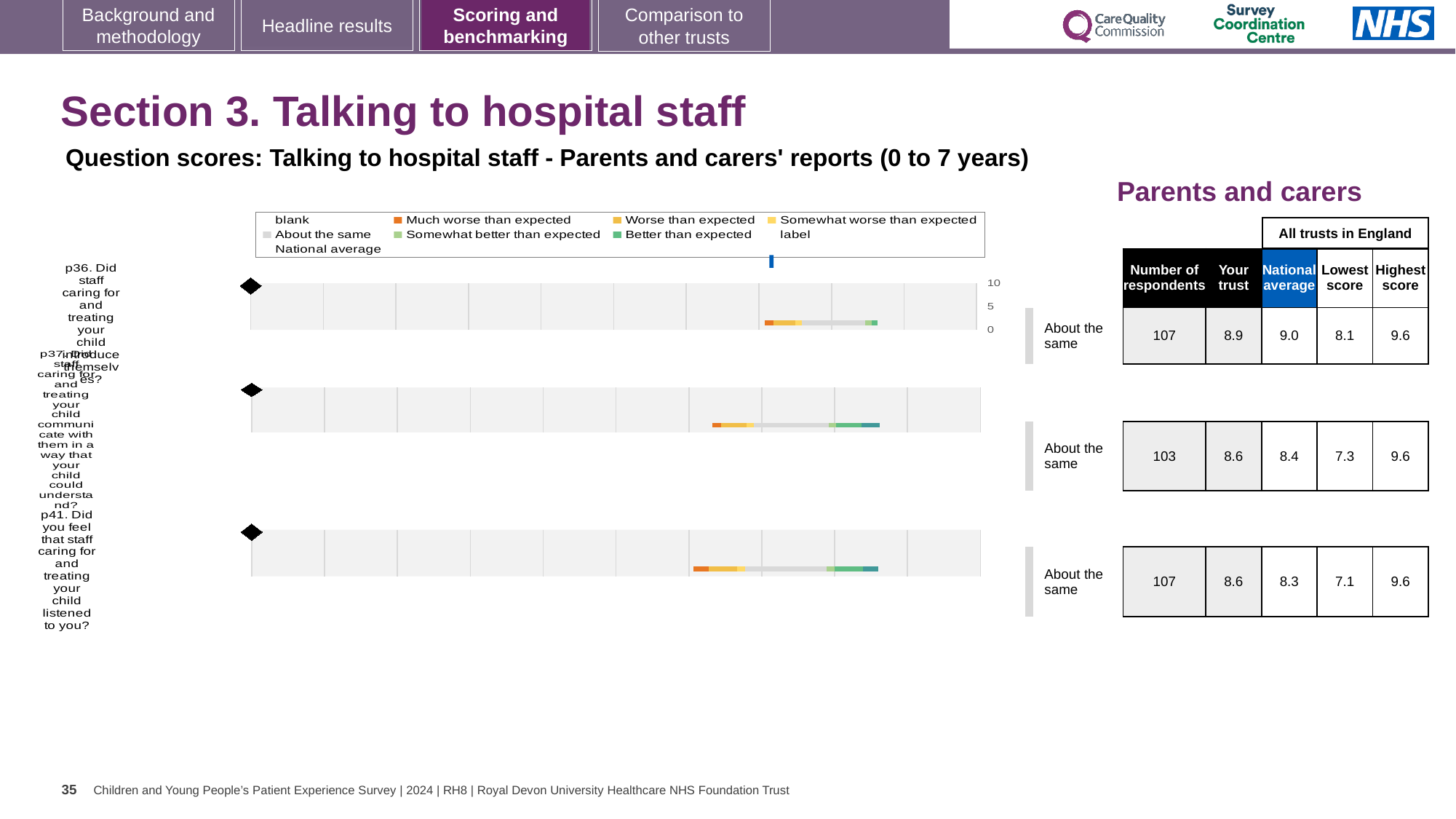
For p37, which is larger: the 'Your trust' score or the national average? Your trust In the table, what is the lowest score across all trusts in England for p36? 8.1 What kind of chart is shown on the slide? bar chart For p41, what is the difference between the highest score and the lowest score in the table? 2.5 In the table, what is the 'Your trust' score for the first question (p36)? 8.9 In the table, what is the national average for the third question (p41)? 8.3 What benchmark label is shown next to each of the three questions? About the same How many survey questions are plotted in the chart? 3 In the table, what is the highest score across all trusts in England for p37? 9.6 What colour does the legend use for 'Much worse than expected'? orange In the table, how many respondents are listed for the second question (p37)? 103 Which question has the highest 'Your trust' score in the table? p36